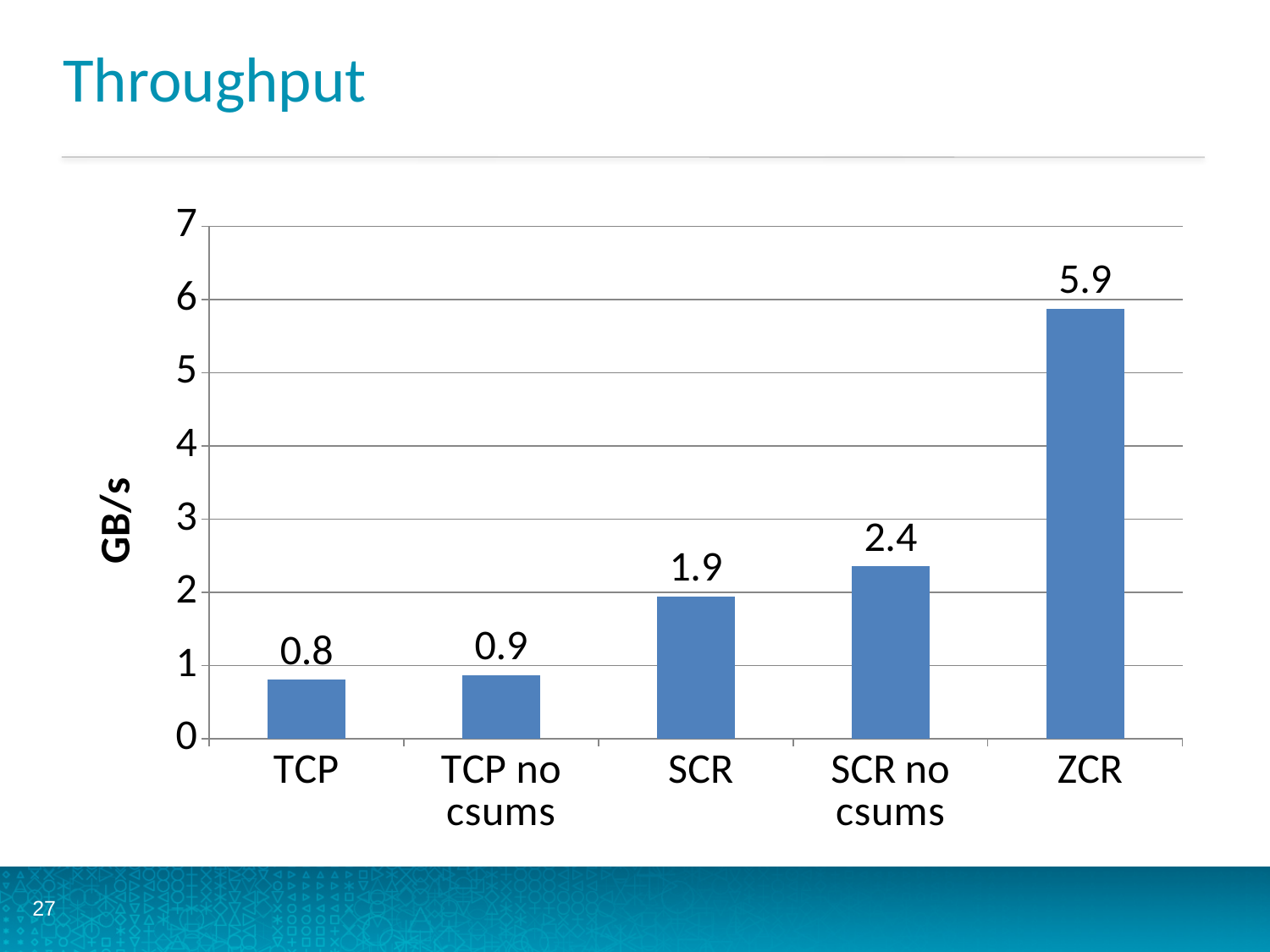
Is the value for ZCR greater or less than 5? greater Which category has the lowest throughput? TCP What is the difference between the SCR and TCP values? 1.1 Which is larger, the value for SCR or the value for TCP no csums? SCR What is the throughput value for SCR no csums? 2.4 What is the throughput value for ZCR? 5.9 What is the difference between the ZCR and SCR no csums values? 3.5 What kind of chart is shown on the slide? bar chart What is the throughput value for TCP? 0.8 What is the label on the y axis? GB/s Which category has the highest throughput? ZCR How many categories are shown on the x axis? 5